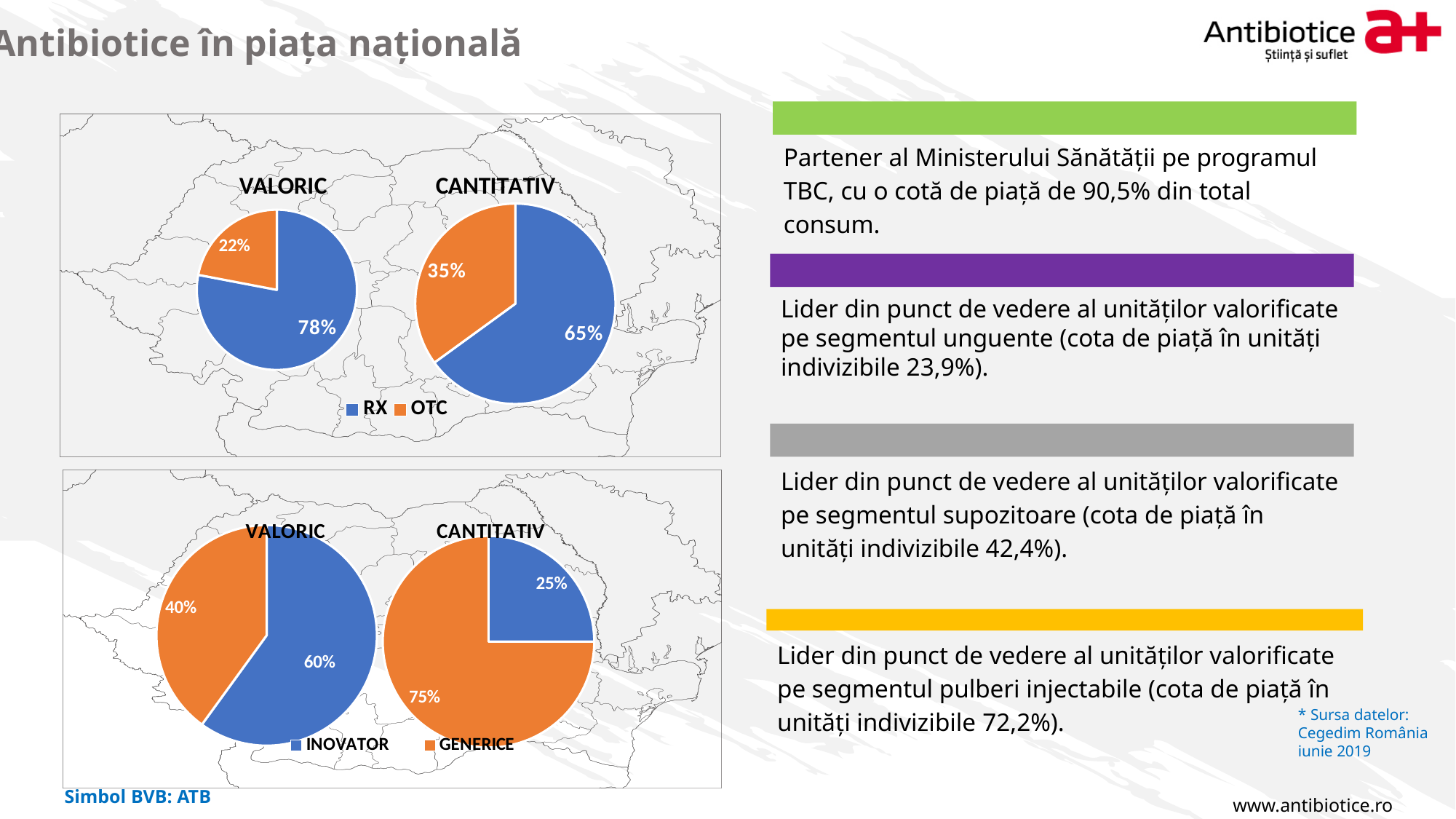
In the top-left VALORIC pie chart (RX/OTC), which slice is the smallest? OTC In the top-left VALORIC pie chart (RX/OTC), what share does OTC hold? 22% In the bottom-left VALORIC pie chart (INOVATOR/GENERICE), what share does INOVATOR hold? 60% In the bottom-right CANTITATIV pie chart (INOVATOR/GENERICE), what share does GENERICE hold? 75% In the bottom-right CANTITATIV pie chart (INOVATOR/GENERICE), which slice is the largest? GENERICE How many entries does the legend of the bottom pair of charts list? 2 In the top-right CANTITATIV pie chart (RX/OTC), what share does RX hold? 65% In the top-right CANTITATIV pie chart (RX/OTC), what share does OTC hold? 35% What type of chart is used for the top-left VALORIC chart? Pie chart In the top-right CANTITATIV pie chart (RX/OTC), what is the difference between the RX and OTC shares? 30% In the bottom-left VALORIC pie chart, which is larger, INOVATOR or GENERICE? INOVATOR In the top-left VALORIC pie chart (RX/OTC), what share does RX hold? 78%